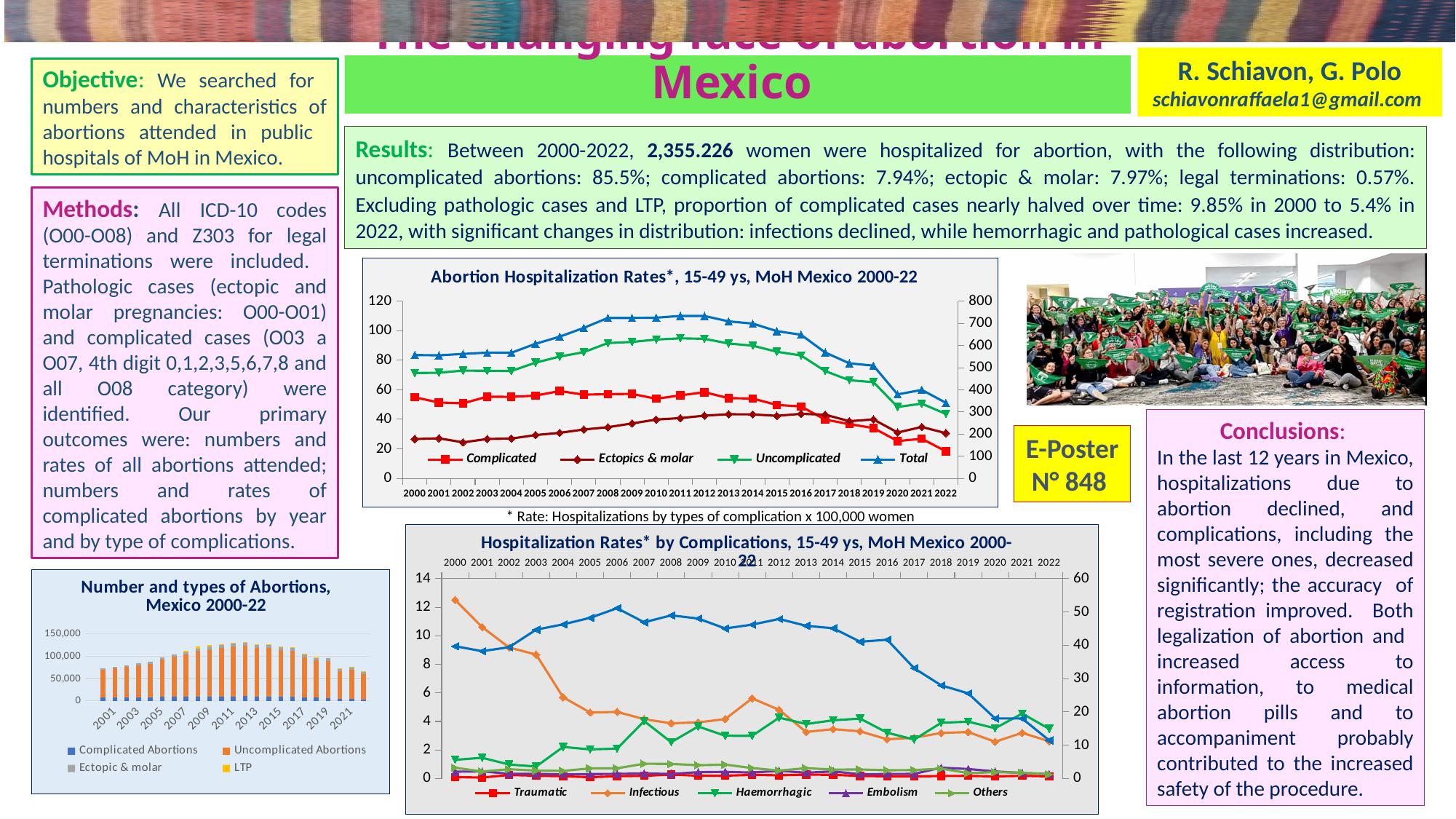
In "Abortion Hospitalization Rates*, 15-49 ys, MoH Mexico 2000-22", is the Complicated value for 2000 greater or less than 40 on the left axis? greater In "Abortion Hospitalization Rates*, 15-49 ys, MoH Mexico 2000-22", which is larger in 2010: Uncomplicated or Complicated? Uncomplicated How many series does the legend of "Abortion Hospitalization Rates*, 15-49 ys, MoH Mexico 2000-22" list? 4 In "Abortion Hospitalization Rates*, 15-49 ys, MoH Mexico 2000-22", how many years are plotted along the x axis? 23 In "Hospitalization Rates* by Complications, 15-49 ys, MoH Mexico 2000-22", is the Infectious value for 2000 greater or less than 10 on the left axis? greater In "Abortion Hospitalization Rates*, 15-49 ys, MoH Mexico 2000-22", is the Ectopics & molar value for 2000 greater or less than 40 on the left axis? less In "Abortion Hospitalization Rates*, 15-49 ys, MoH Mexico 2000-22", does the Total series rise or fall between 2012 and 2022? Fall How many series does the legend of "Hospitalization Rates* by Complications, 15-49 ys, MoH Mexico 2000-22" list? 5 What kind of chart is "Number and types of Abortions, Mexico 2000-22"? Bar chart What kind of chart is "Abortion Hospitalization Rates*, 15-49 ys, MoH Mexico 2000-22"? Line chart In "Hospitalization Rates* by Complications, 15-49 ys, MoH Mexico 2000-22", does the Infectious series rise or fall between 2000 and 2022? Fall How many series does the legend of "Number and types of Abortions, Mexico 2000-22" list? 4